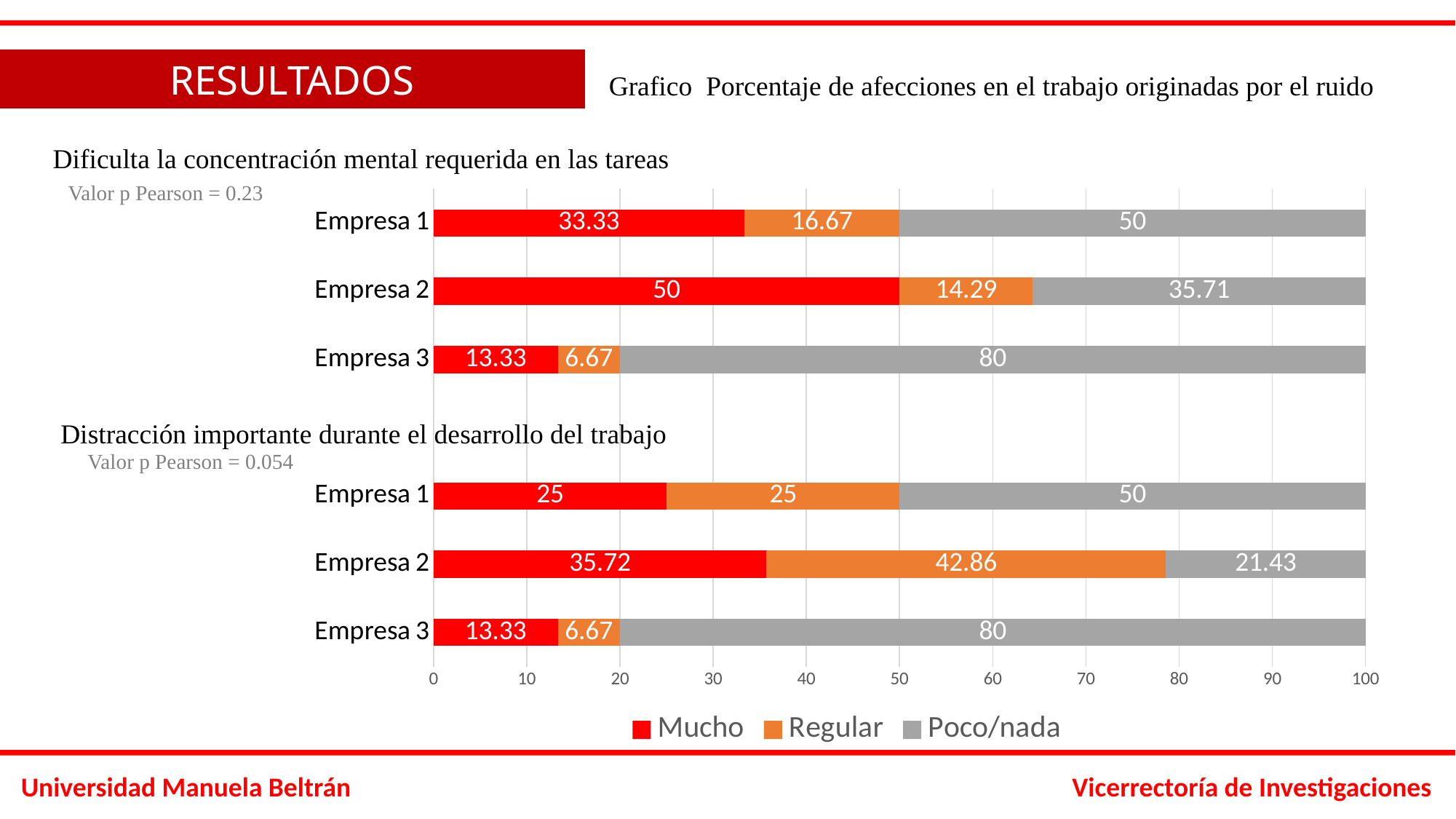
Under 'Dificulta la concentración mental requerida en las tareas', which Empresa has the highest 'Mucho' value? Empresa 2 What is the Valor p Pearson shown for 'Distracción importante durante el desarrollo del trabajo'? 0.054 Under 'Distracción importante durante el desarrollo del trabajo', what is the 'Regular' value for Empresa 2? 42.86 Under 'Distracción importante durante el desarrollo del trabajo', what is the total of the stacked bar for Empresa 1? 100 How many series does the legend list? 3 Under 'Dificulta la concentración mental requerida en las tareas', what is the difference between the 'Poco/nada' values of Empresa 3 and Empresa 1? 30 Under 'Distracción importante durante el desarrollo del trabajo', which is larger for Empresa 2: the 'Mucho' value or the 'Regular' value? Regular Under 'Distracción importante durante el desarrollo del trabajo', what is the 'Poco/nada' value for Empresa 3? 80 Under 'Dificulta la concentración mental requerida en las tareas', what is the 'Regular' value for Empresa 1? 16.67 Under 'Dificulta la concentración mental requerida en las tareas', what is the 'Mucho' value for Empresa 2? 50 What kind of chart is shown on the slide? stacked bar chart Under 'Distracción importante durante el desarrollo del trabajo', which Empresa has the lowest 'Poco/nada' value? Empresa 2